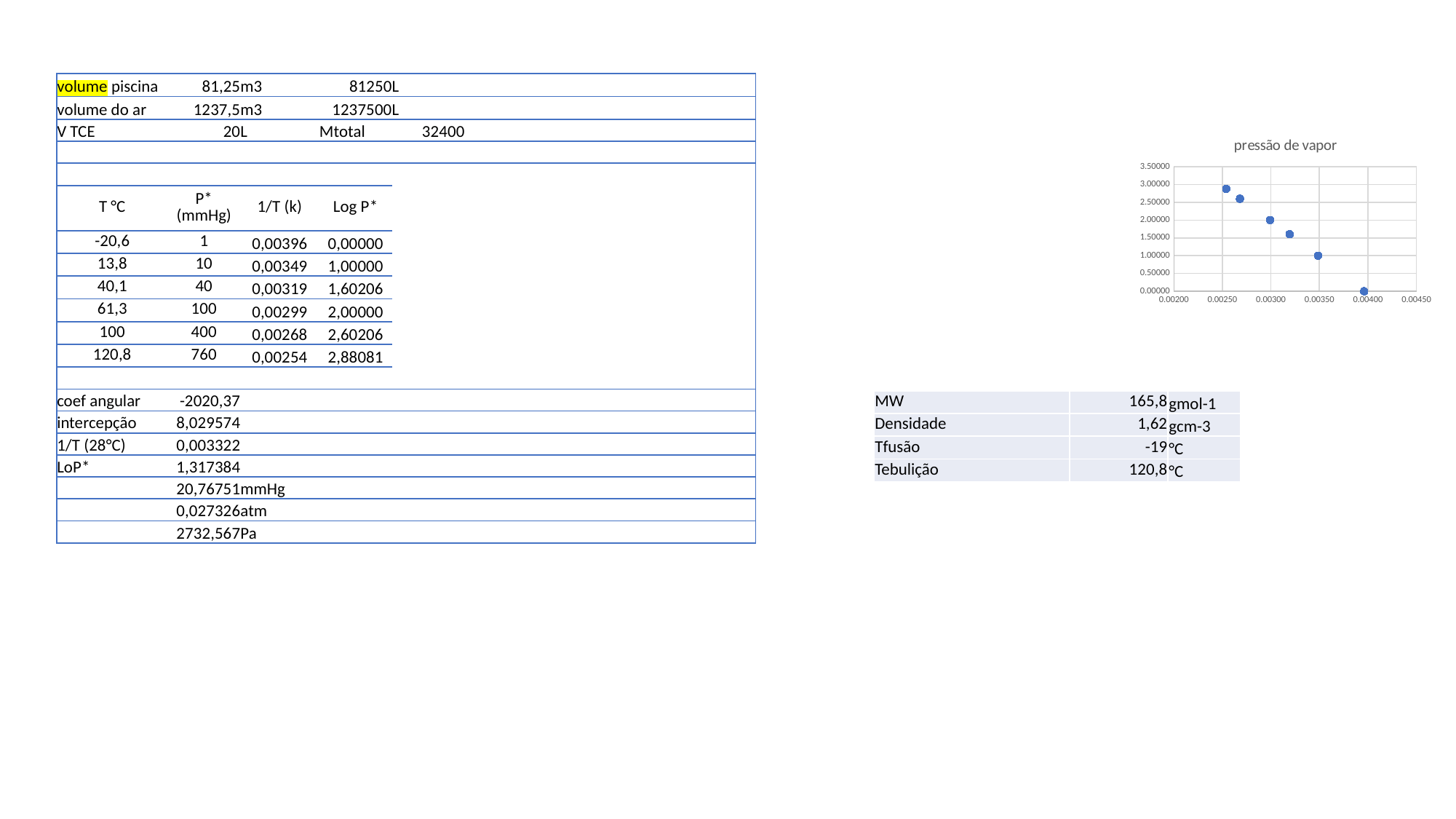
What is the maximum value shown on the y-axis of the chart? 3.50000 What is the y value of the rightmost point in the chart? 0.00000 What kind of chart is shown on the slide? scatter chart How many data points are plotted in the chart? 6 Is the value of the second point from the left (near x = 0.00270) greater or less than 2.50000? greater Is the value of the point near x = 0.00320 greater or less than 2.00000? less Is the value of the leftmost point (near x = 0.00250) greater or less than 2.50000? greater What is the title of the chart? pressão de vapor Do the plotted values rise or fall as the x-axis value increases? fall Which point has the highest y value: the leftmost point or the rightmost point? the leftmost point